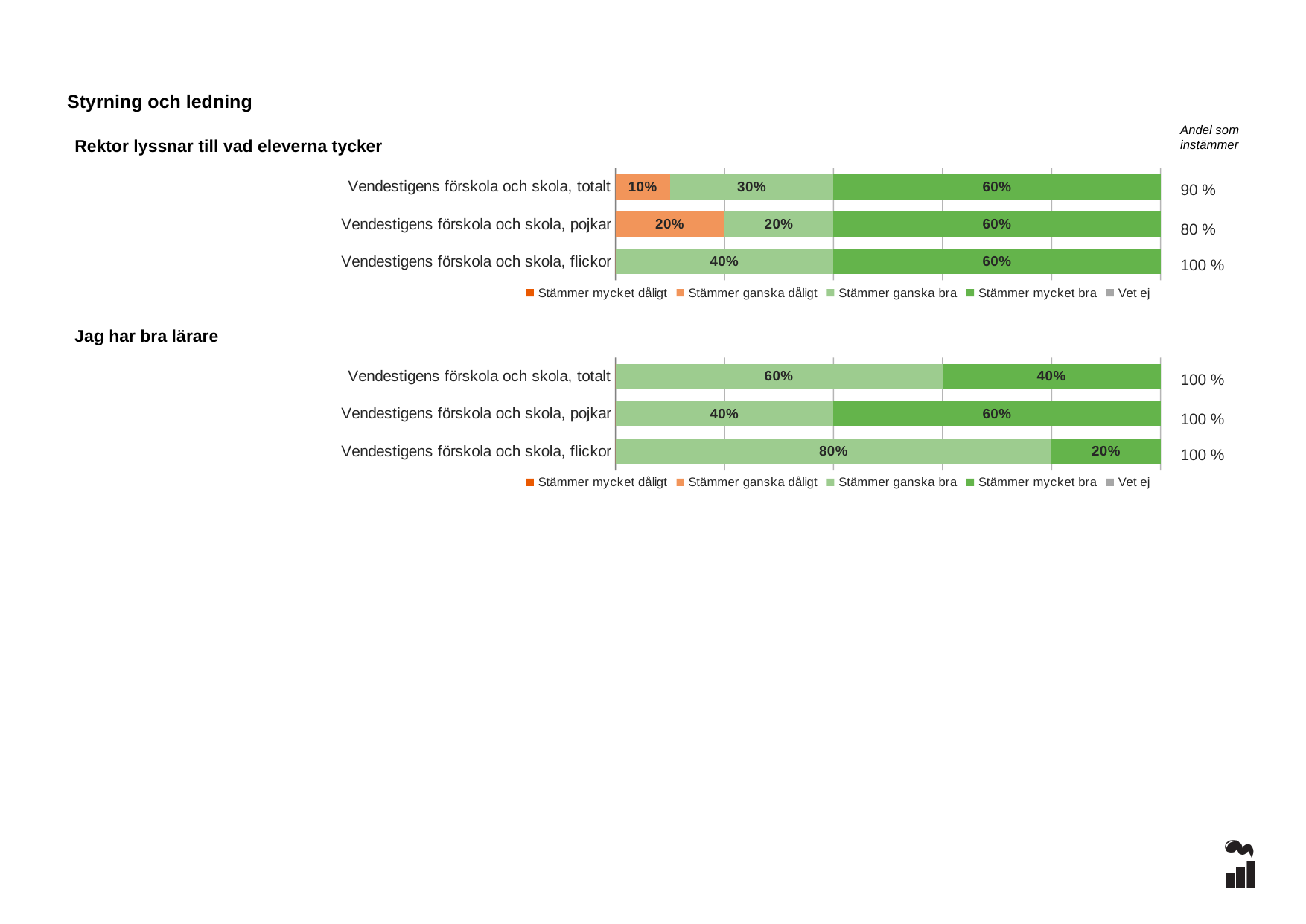
In the 'Rektor lyssnar till vad eleverna tycker' chart, which category has the lowest 'Andel som instämmer' value? Vendestigens förskola och skola, pojkar In the 'Jag har bra lärare' chart, what is the 'Stämmer mycket bra' value for 'Vendestigens förskola och skola, totalt'? 40% In the 'Jag har bra lärare' chart, which category has the highest 'Stämmer ganska bra' value? Vendestigens förskola och skola, flickor What kind of chart is the 'Jag har bra lärare' chart? Stacked bar chart In the 'Rektor lyssnar till vad eleverna tycker' chart, what is the 'Stämmer ganska bra' value for 'Vendestigens förskola och skola, flickor'? 40% In the 'Rektor lyssnar till vad eleverna tycker' chart, what is the 'Stämmer ganska dåligt' value for 'Vendestigens förskola och skola, pojkar'? 20% In the 'Rektor lyssnar till vad eleverna tycker' chart, what is the 'Andel som instämmer' value shown for 'Vendestigens förskola och skola, pojkar'? 80 % How many series does the legend of the 'Rektor lyssnar till vad eleverna tycker' chart list? 5 How many categories are shown in the 'Jag har bra lärare' chart? 3 In the 'Jag har bra lärare' chart, what is the 'Stämmer ganska bra' value for 'Vendestigens förskola och skola, flickor'? 80% In the 'Jag har bra lärare' chart, what is the difference between the 'Stämmer ganska bra' values for 'Vendestigens förskola och skola, flickor' and 'Vendestigens förskola och skola, pojkar'? 40% In the 'Rektor lyssnar till vad eleverna tycker' chart, which is larger: the 'Stämmer ganska bra' value for 'Vendestigens förskola och skola, totalt' or for 'Vendestigens förskola och skola, pojkar'? Vendestigens förskola och skola, totalt